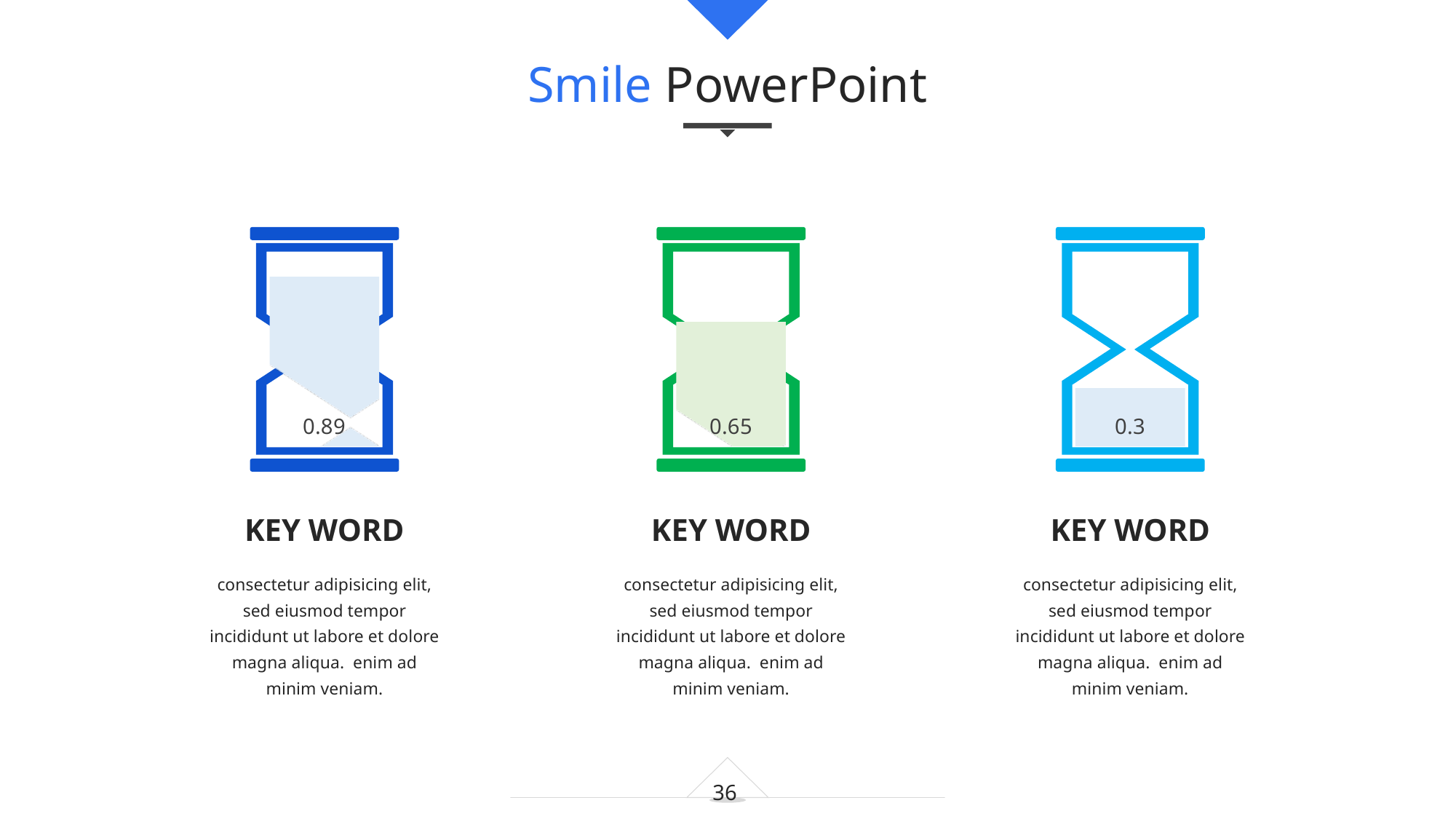
What is the difference between the values of the left and middle hourglasses? 0.24 Which hourglass shows the highest value? The left (dark blue) hourglass, 0.89 How many hourglass graphics with values are shown on the slide? 3 Do the values decrease or increase from the left hourglass to the right hourglass? Decrease Which hourglass shows the lowest value? The right (light blue) hourglass, 0.3 What value is shown in the middle (green) hourglass? 0.65 Which is larger, the value in the green hourglass or the value in the light blue hourglass? The green hourglass (0.65) What value is shown in the left (dark blue) hourglass? 0.89 What is the difference between the values of the middle and right hourglasses? 0.35 What colour is the hourglass that shows the value 0.65? Green What value is shown in the right (light blue) hourglass? 0.3 What is the difference between the values of the left and right hourglasses? 0.59